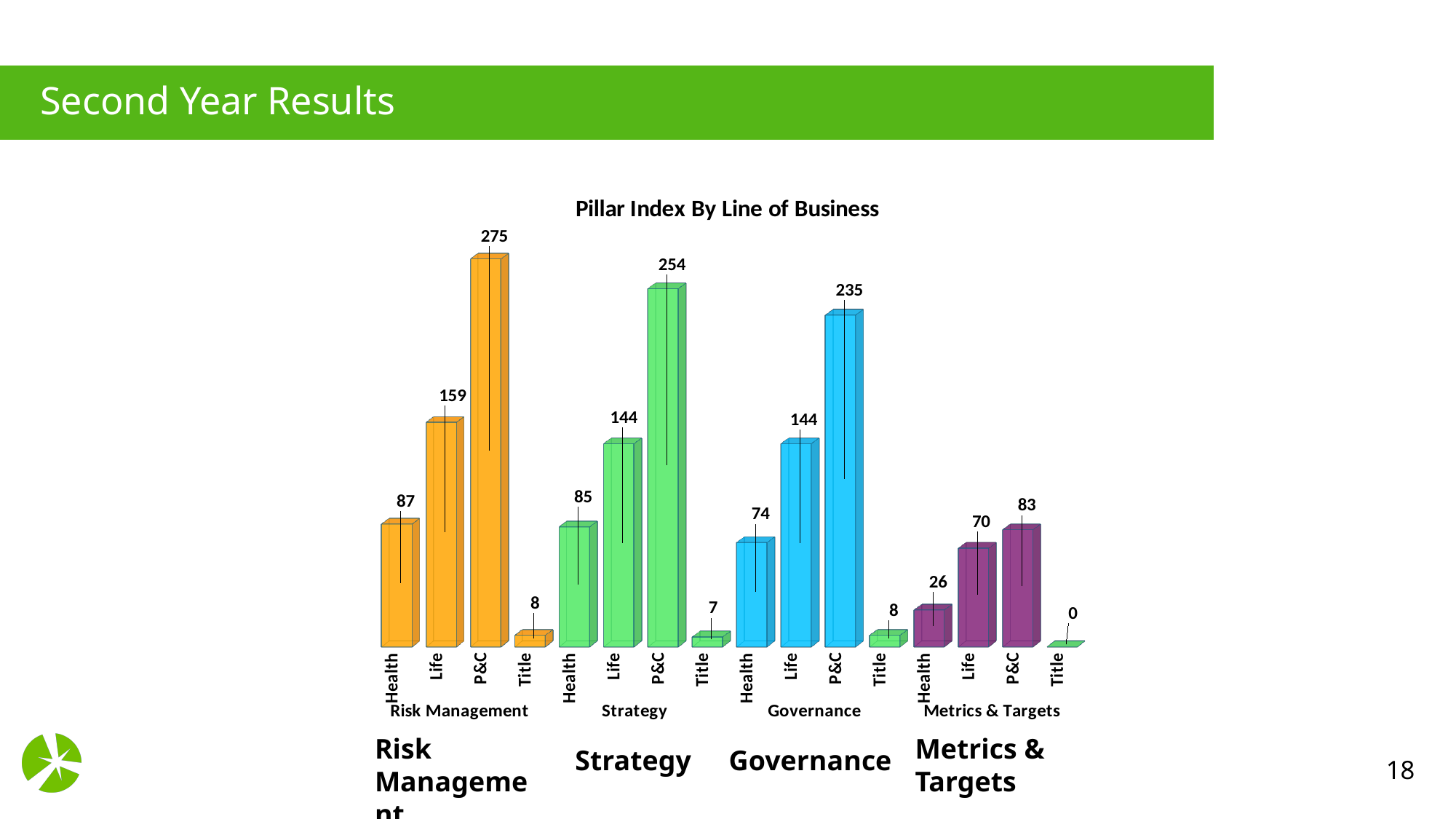
What is the value for Health under Governance? 74 Which bar has the highest value in the whole chart? P&C under Risk Management What is the title of the chart? Pillar Index By Line of Business What is the total of the four values in the Metrics & Targets group? 179 Which is larger: Life under Risk Management or Life under Governance? Life under Risk Management What is the value for P&C under Risk Management? 275 Within the Metrics & Targets group, which line of business has the lowest value? Title What is the value for Title under Metrics & Targets? 0 What is the difference between the P&C values for Strategy and Governance? 19 How many pillar groups are shown along the x axis? 4 What is the value for Life under Strategy? 144 What type of chart is shown on the slide? Bar chart